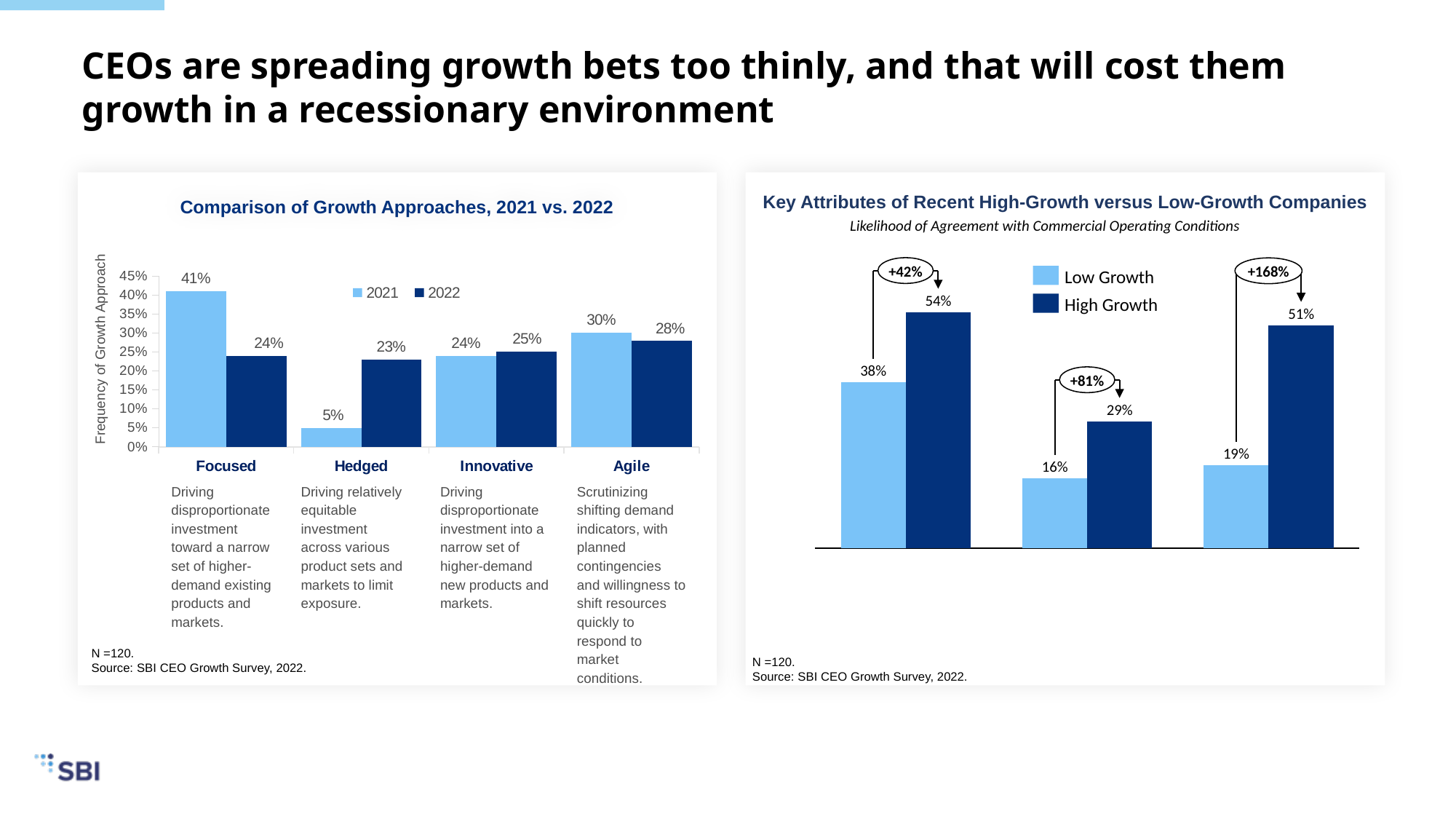
In the 'Key Attributes of Recent High-Growth versus Low-Growth Companies' chart, what is the difference between the High Growth and Low Growth values in the middle group of bars? 13% In the 'Key Attributes of Recent High-Growth versus Low-Growth Companies' chart, what is the High Growth value in the leftmost group of bars? 54% In the 'Comparison of Growth Approaches, 2021 vs. 2022' chart, which growth approach has the lowest 2021 value? Hedged In the 'Comparison of Growth Approaches, 2021 vs. 2022' chart, what is the 2021 value for Focused? 41% What kind of chart is the 'Key Attributes of Recent High-Growth versus Low-Growth Companies' chart? Bar chart In the 'Comparison of Growth Approaches, 2021 vs. 2022' chart, what is the 2022 value for Hedged? 23% In the 'Comparison of Growth Approaches, 2021 vs. 2022' chart, which growth approach has the highest 2022 value? Agile In the 'Key Attributes of Recent High-Growth versus Low-Growth Companies' chart, what is the Low Growth value in the rightmost group of bars? 19% In the 'Comparison of Growth Approaches, 2021 vs. 2022' chart, what is the difference between the 2021 and 2022 values for Focused? 17% In the 'Comparison of Growth Approaches, 2021 vs. 2022' chart, how many growth approaches are shown on the x axis? 4 In the 'Comparison of Growth Approaches, 2021 vs. 2022' chart, how many series does the legend list? 2 In the 'Comparison of Growth Approaches, 2021 vs. 2022' chart, what is the label of the vertical axis? Frequency of Growth Approach